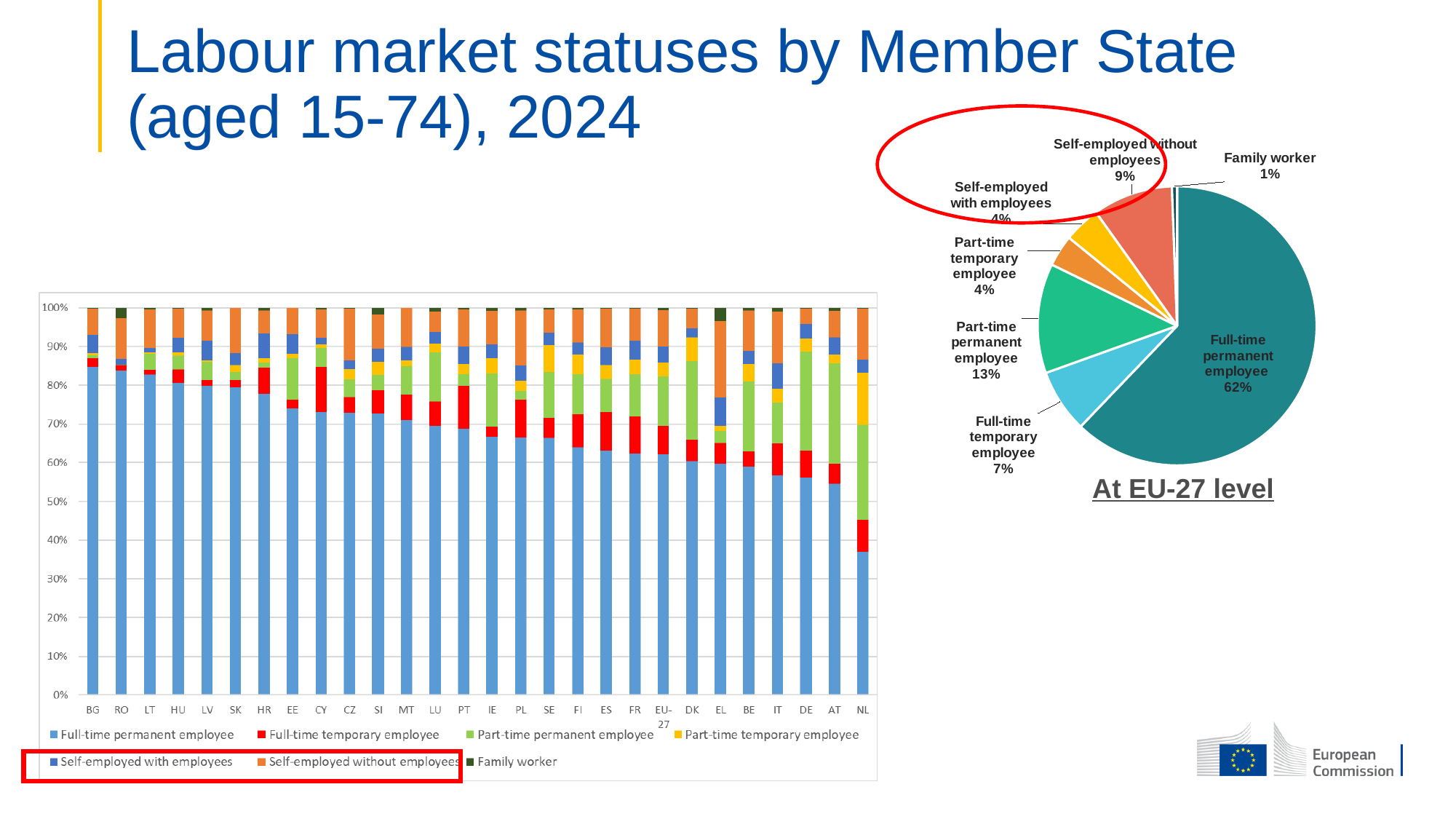
In the stacked bar chart on the left, is the Full-time permanent employee share for NL greater or less than 40%? less What kind of chart is the chart on the left of the slide? Stacked bar chart In the stacked bar chart on the left, which category has the lowest share of Full-time permanent employee? NL In the stacked bar chart on the left, how many series does the legend list? 7 In the pie chart 'At EU-27 level', what share is Full-time permanent employee? 62% In the pie chart 'At EU-27 level', what is the difference in percentage points between Full-time permanent employee and Part-time permanent employee? 49 percentage points In the pie chart 'At EU-27 level', which category has the largest slice? Full-time permanent employee In the stacked bar chart on the left, how many categories are shown on the x axis? 28 In the pie chart 'At EU-27 level', what share is Part-time permanent employee? 13% In the pie chart 'At EU-27 level', what share is Self-employed without employees? 9% In the pie chart 'At EU-27 level', which is larger: Self-employed without employees or Full-time temporary employee? Self-employed without employees In the pie chart 'At EU-27 level', which category has the smallest slice? Family worker